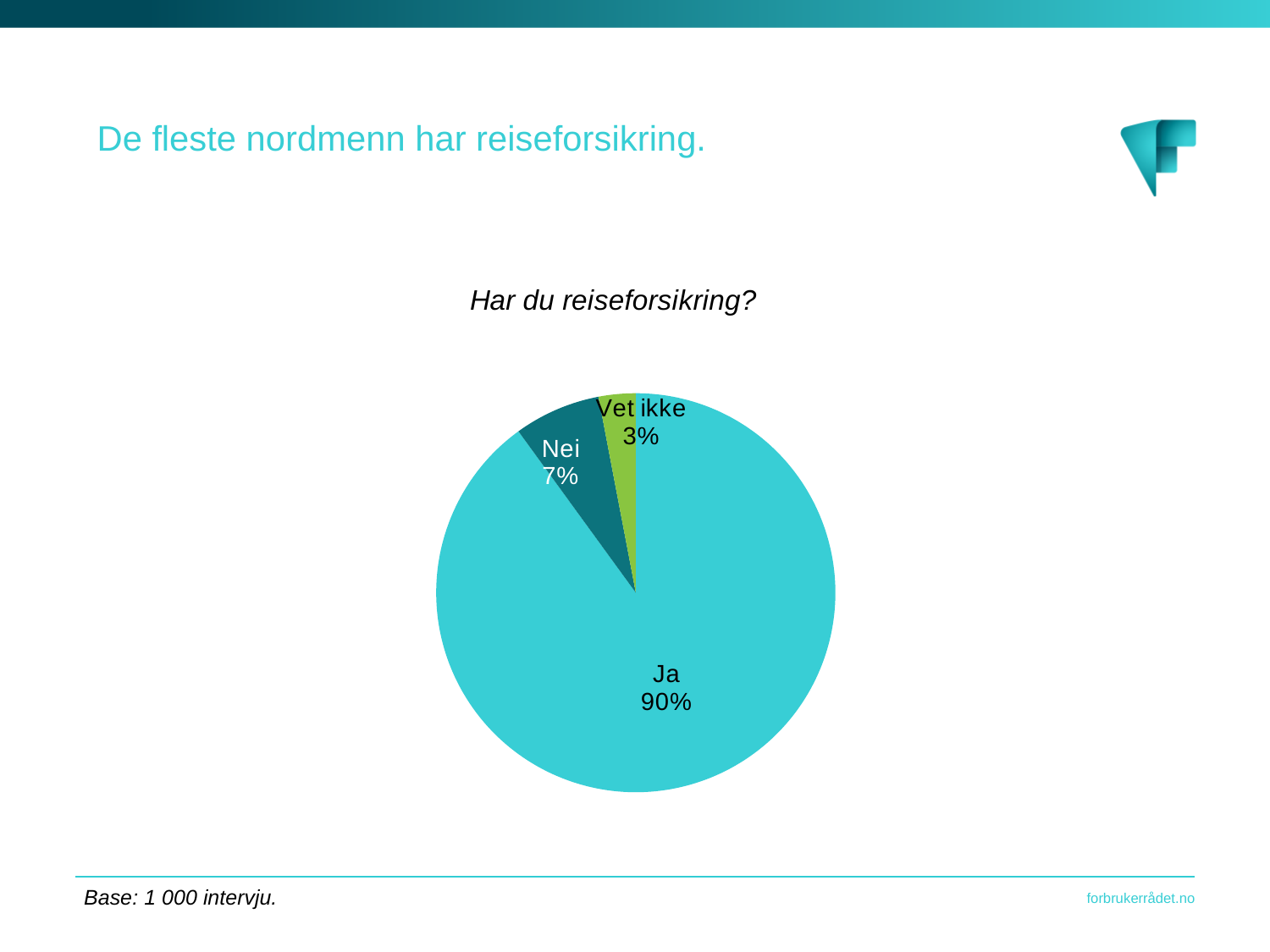
What percentage of respondents answered "Nei"? 7% Which category has the largest slice of the pie? Ja Which is larger, the share for "Nei" or the share for "Vet ikke"? Nei What colour is the "Vet ikke" slice? green What percentage of respondents answered "Ja"? 90% Which category has the smallest slice of the pie? Vet ikke What is the title of the chart? Har du reiseforsikring? What is the difference in percentage points between "Nei" and "Vet ikke"? 4 What kind of chart is shown on the slide? pie chart How many slices does the pie chart have? 3 What percentage of respondents answered "Vet ikke"? 3% What is the difference in percentage points between "Ja" and "Nei"? 83